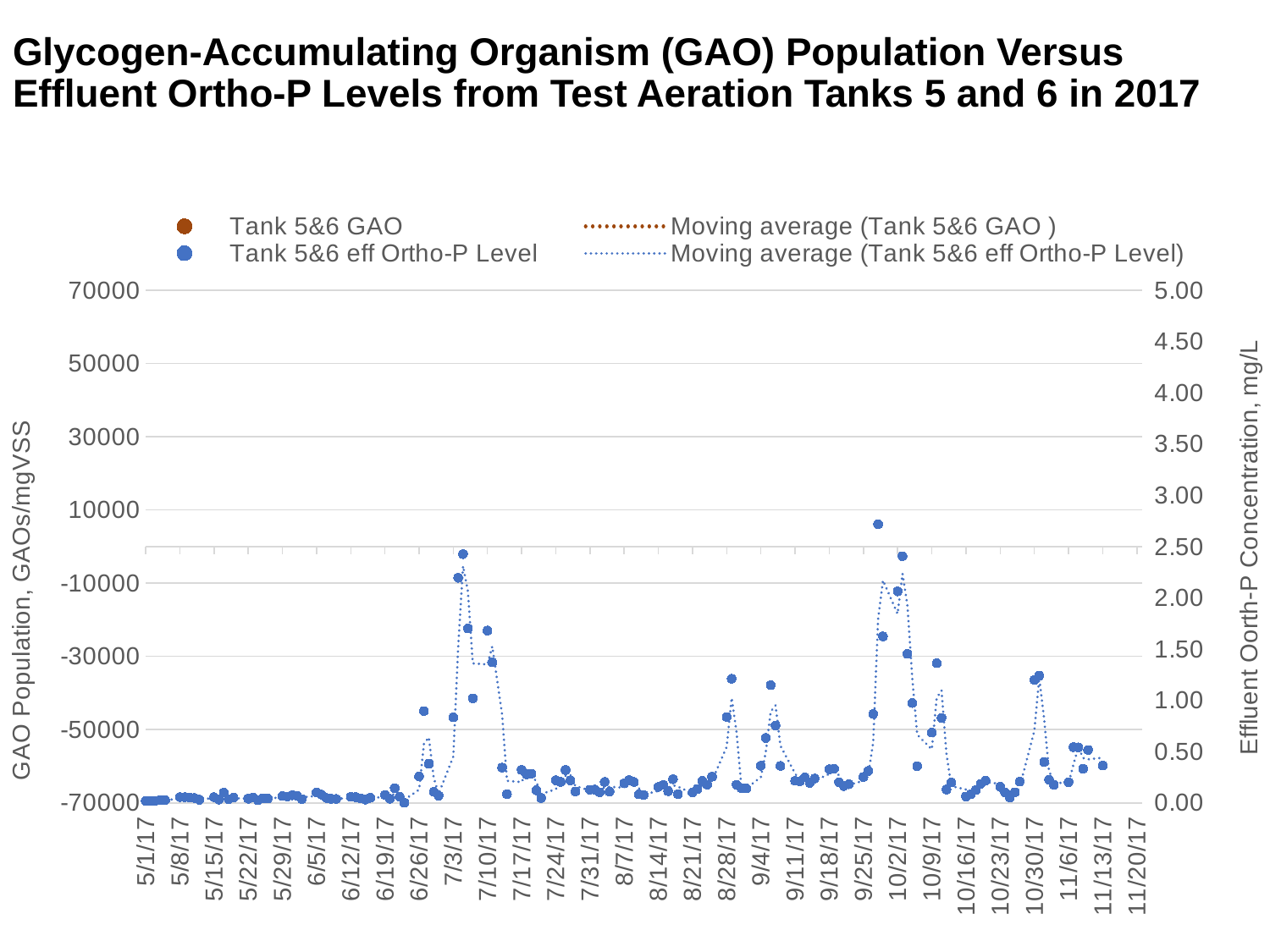
In which period does the Tank 5&6 eff Ortho-P Level reach its highest point? between 9/25/17 and 10/2/17 Do the Tank 5&6 eff Ortho-P Level values rise or fall from 6/26/17 to 7/3/17? rise What is the label of the right-hand vertical axis? Effluent Oorth-P Concentration, mg/L Do the Tank 5&6 eff Ortho-P Level values rise or fall from 10/2/17 to 10/16/17? fall Is the peak Tank 5&6 eff Ortho-P Level value around 7/3/17–7/10/17 greater or less than 2.00 mg/L? greater Are the Tank 5&6 eff Ortho-P Level values in May 2017 greater or less than 0.50 mg/L? less Is the peak Tank 5&6 eff Ortho-P Level value around 8/28/17 greater or less than 1.50 mg/L? less Which is larger: the peak Tank 5&6 eff Ortho-P Level around 10/2/17 or the peak around 10/30/17? the peak around 10/2/17 What is the title of the chart? Glycogen-Accumulating Organism (GAO) Population Versus Effluent Ortho-P Levels from Test Aeration Tanks 5 and 6 in 2017 How many series does the legend list? 4 What kind of chart is shown on the slide? scatter chart